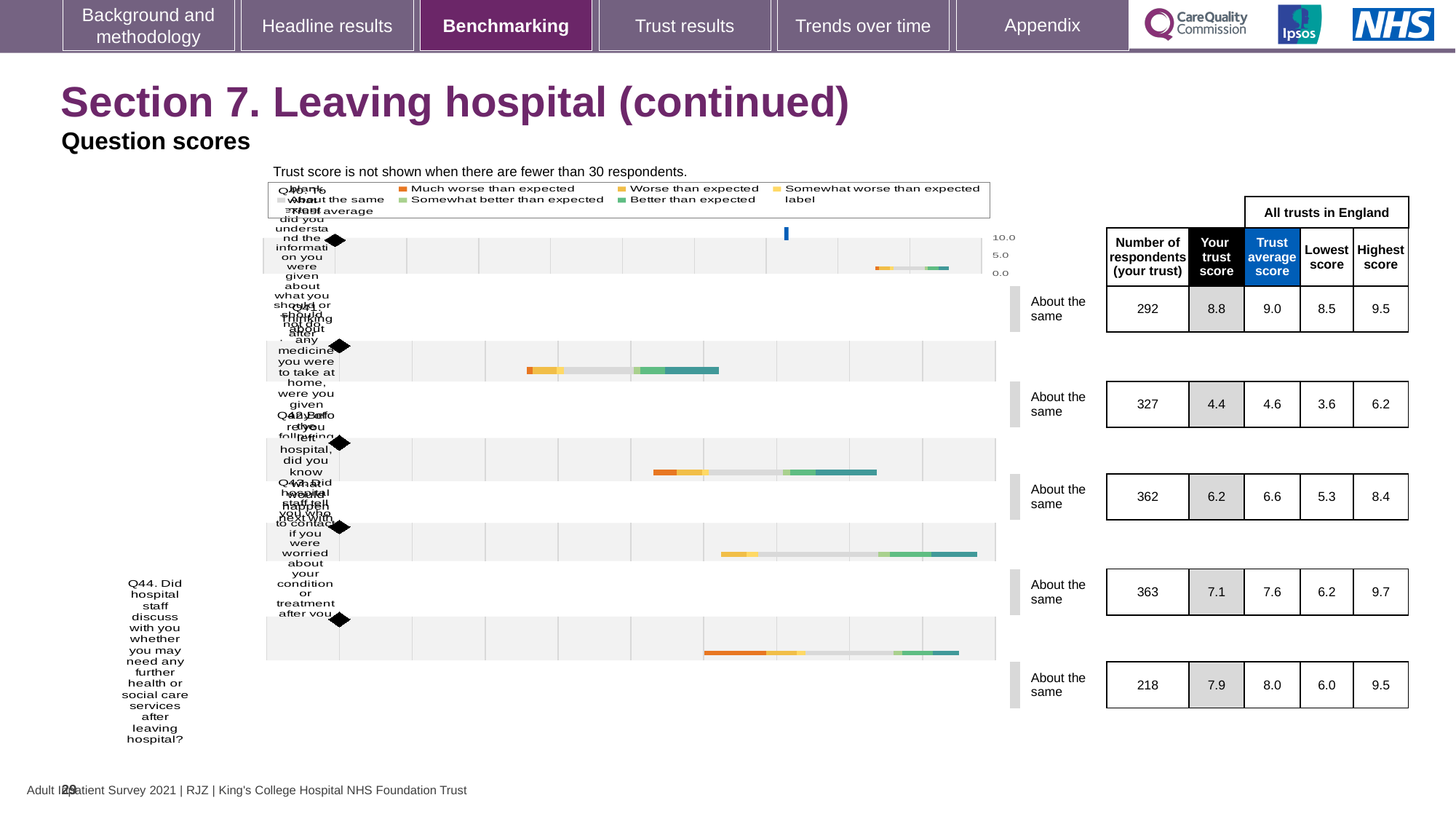
Which question row has the highest 'Your trust score'? The first row (8.8) How many respondents (your trust) are shown for Q44? 218 Which question row has the lowest 'Your trust score'? The second row (4.4) What is the difference between the Trust average score and Your trust score for Q44? 0.1 What is the 'Your trust score' for the first question row (top row) of the chart? 8.8 What benchmark category is shown for every question row in the chart? About the same What is the Highest score across all trusts in England for Q44? 9.5 What kind of chart is used to show the question scores? Bar chart What is the 'Your trust score' for Q44 (Did hospital staff discuss with you whether you may need any further health or social care services after leaving hospital?)? 7.9 How many question rows are plotted in the chart? 5 Is the Trust average score for the first row larger or smaller than Your trust score for that row? Larger What is the Trust average score for Q44? 8.0